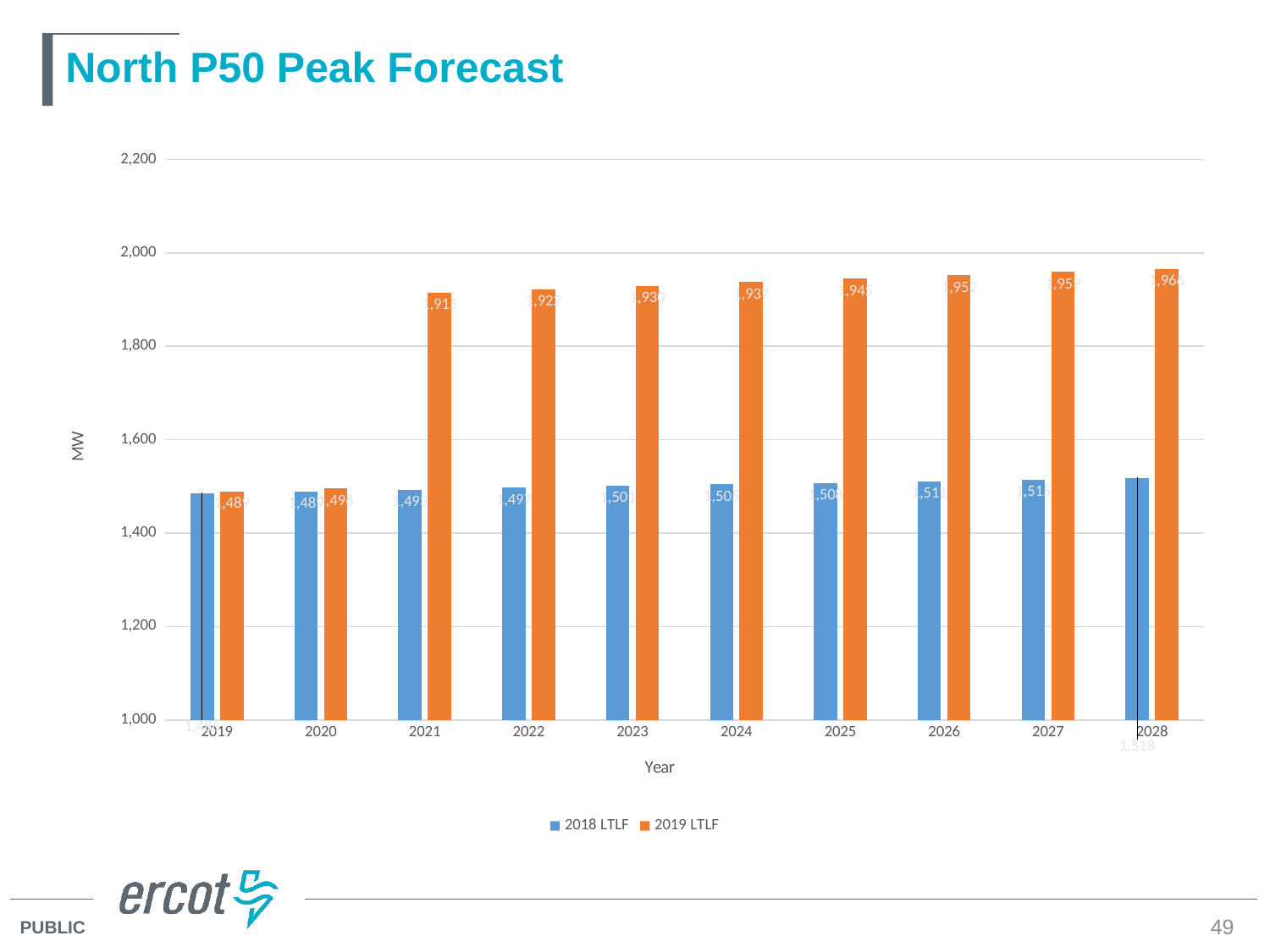
Is the 2019 LTLF value for 2019 greater or less than 1,800? less What is the label on the y axis? MW What is the 2019 LTLF value for 2021? 1,915 For 2024, which series has the larger value, 2018 LTLF or 2019 LTLF? 2019 LTLF What is the 2019 LTLF value for 2028? 1,966 How many years are shown on the x axis? 10 Is the 2018 LTLF value for 2020 greater or less than 1,600? less What is the 2018 LTLF value for 2028? 1,518 What kind of chart is shown on the slide? Bar chart What is the difference between the 2019 LTLF and 2018 LTLF values for 2028? 448 How many series does the legend list? 2 In which year is the 2019 LTLF value highest? 2028